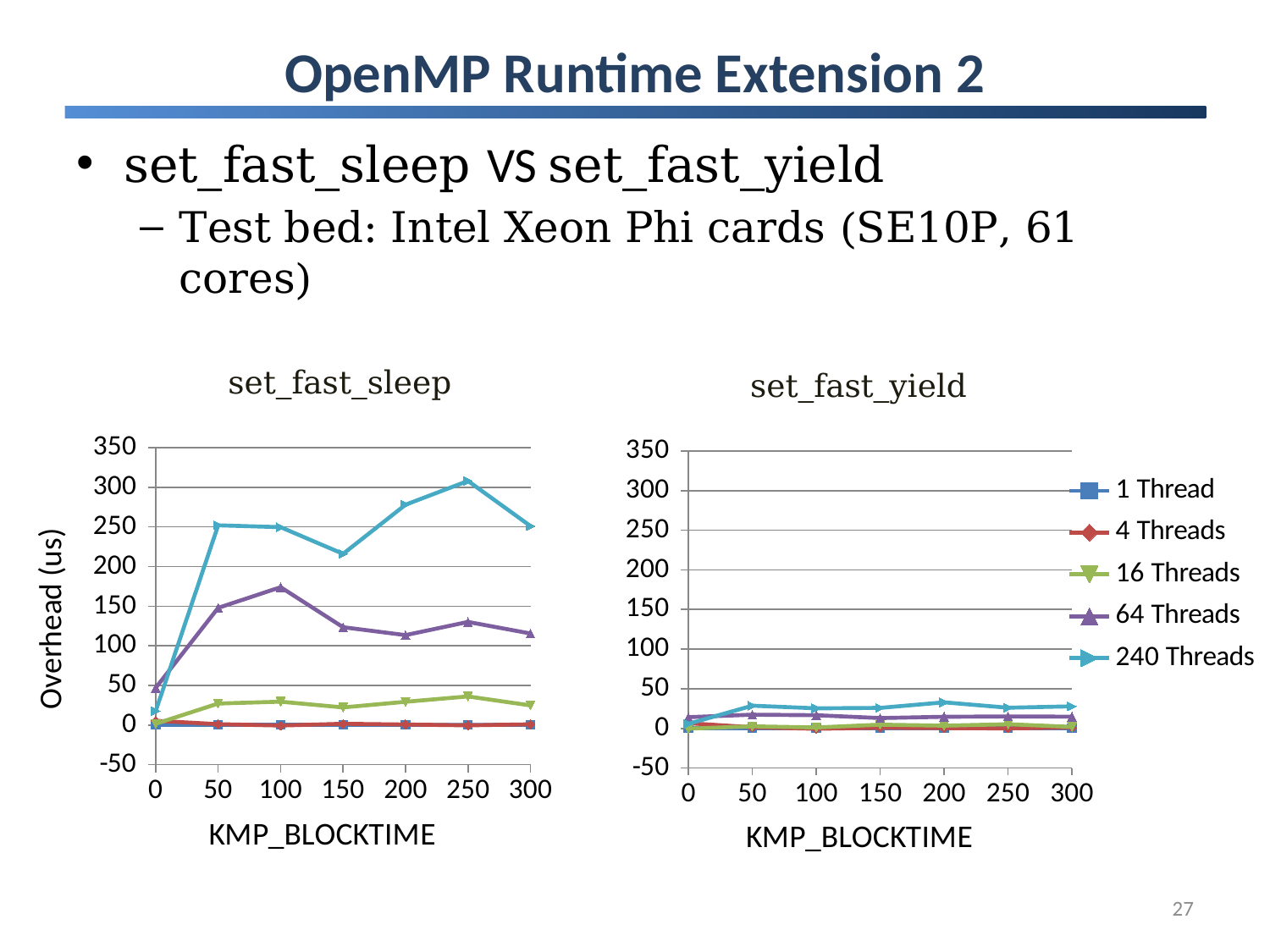
In the set_fast_sleep chart, which is larger at KMP_BLOCKTIME 200: the value for 64 Threads or the value for 16 Threads? 64 Threads In the set_fast_sleep chart, is the value for 240 Threads at KMP_BLOCKTIME 250 greater or less than 300? greater What is the y-axis label of the set_fast_sleep chart? Overhead (us) What kind of chart is the set_fast_sleep chart? line chart In the set_fast_sleep chart, does the 240 Threads series rise or fall between KMP_BLOCKTIME 0 and 50? rise How many KMP_BLOCKTIME points are plotted for each series in the set_fast_yield chart? 7 How many series does the legend list for the charts? 5 In the set_fast_sleep chart, is the value for 240 Threads at KMP_BLOCKTIME 150 greater or less than 250? less In the set_fast_yield chart, is the value for 240 Threads at KMP_BLOCKTIME 200 greater or less than 50? less In the set_fast_sleep chart, does the 64 Threads series rise or fall between KMP_BLOCKTIME 100 and 150? fall In the set_fast_sleep chart, which series has the highest overhead at KMP_BLOCKTIME 250? 240 Threads